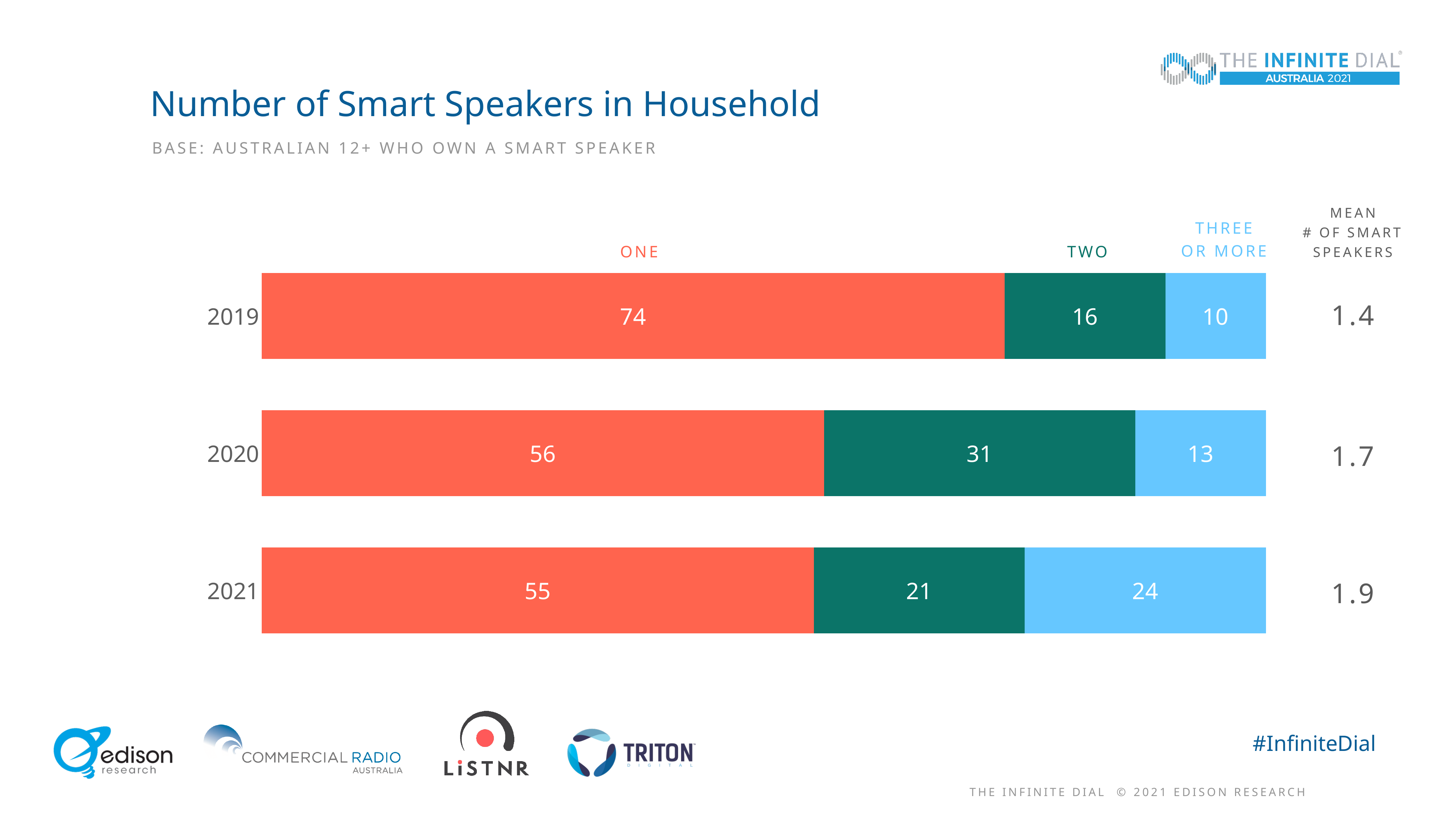
How many years are shown in the chart? 3 Which year has the highest value for 'Three or more' smart speakers? 2021 What is the difference between the 'One' values for 2019 and 2021? 19 Does the mean number of smart speakers rise or fall from 2019 to 2021? Rise How many series does the chart show? 3 What is the mean number of smart speakers shown for 2021? 1.9 Which is larger: the 'Two' value in 2020 or the 'Two' value in 2021? 2020 What is the value for 'Three or more' smart speakers in 2021? 24 What kind of chart is shown on the slide? Stacked bar chart What is the value for 'One' smart speaker in 2019? 74 What is the value for 'Two' smart speakers in 2020? 31 Which year has the lowest value for 'One' smart speaker? 2021